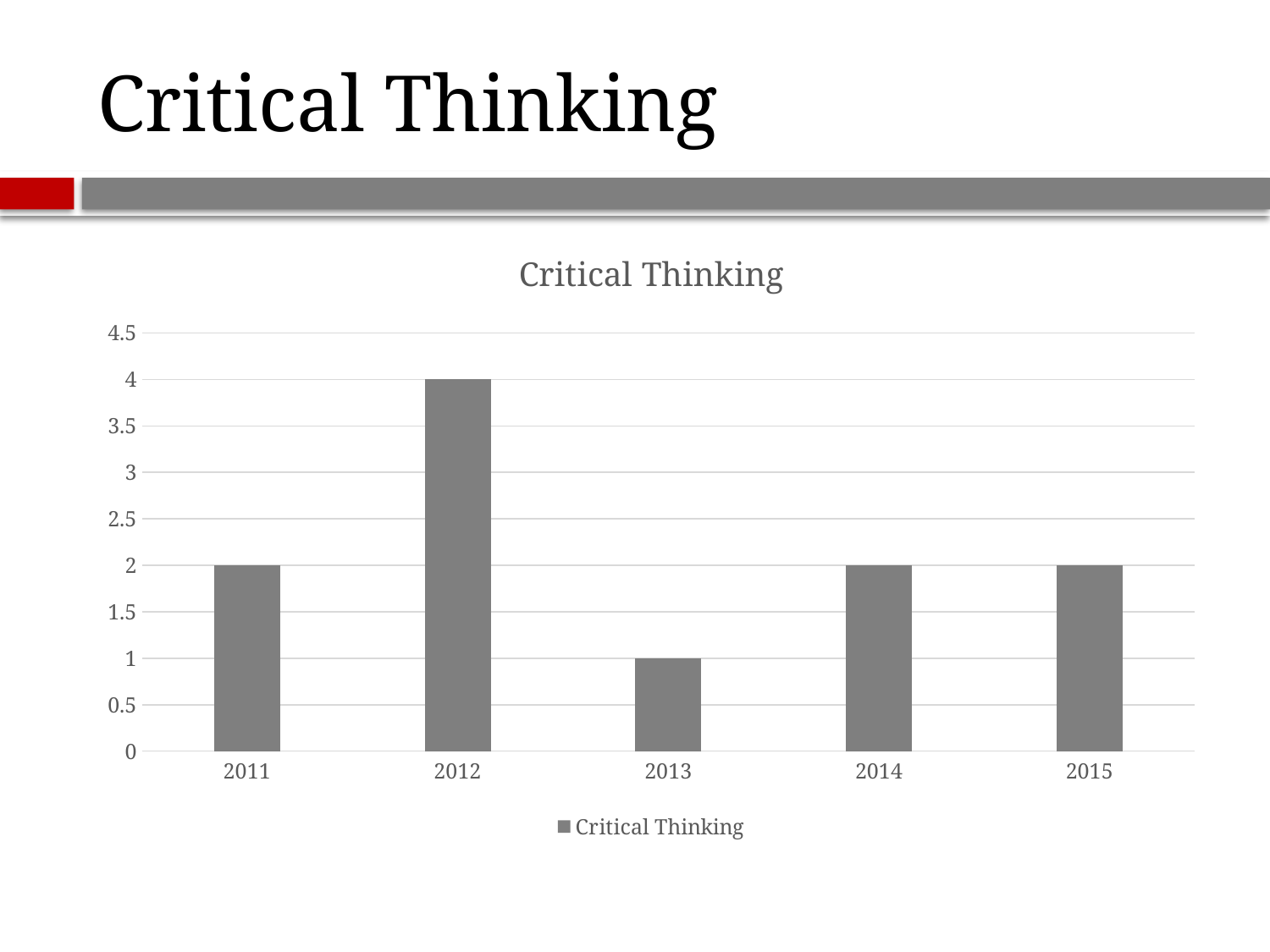
What is the value for 2011 in the Critical Thinking chart? 2 What kind of chart is shown on the slide? bar chart What is the value for 2012 in the Critical Thinking chart? 4 Which year has the highest value in the Critical Thinking chart? 2012 How many series does the legend list? 1 What is the value for 2013 in the Critical Thinking chart? 1 Which year has the lowest value in the Critical Thinking chart? 2013 Which is larger, the value for 2012 or the value for 2014? 2012 How many years are shown on the x axis of the chart? 5 What is the difference between the values for 2012 and 2013? 3 Is the value for 2012 greater or less than 3? greater What is the title of the chart? Critical Thinking